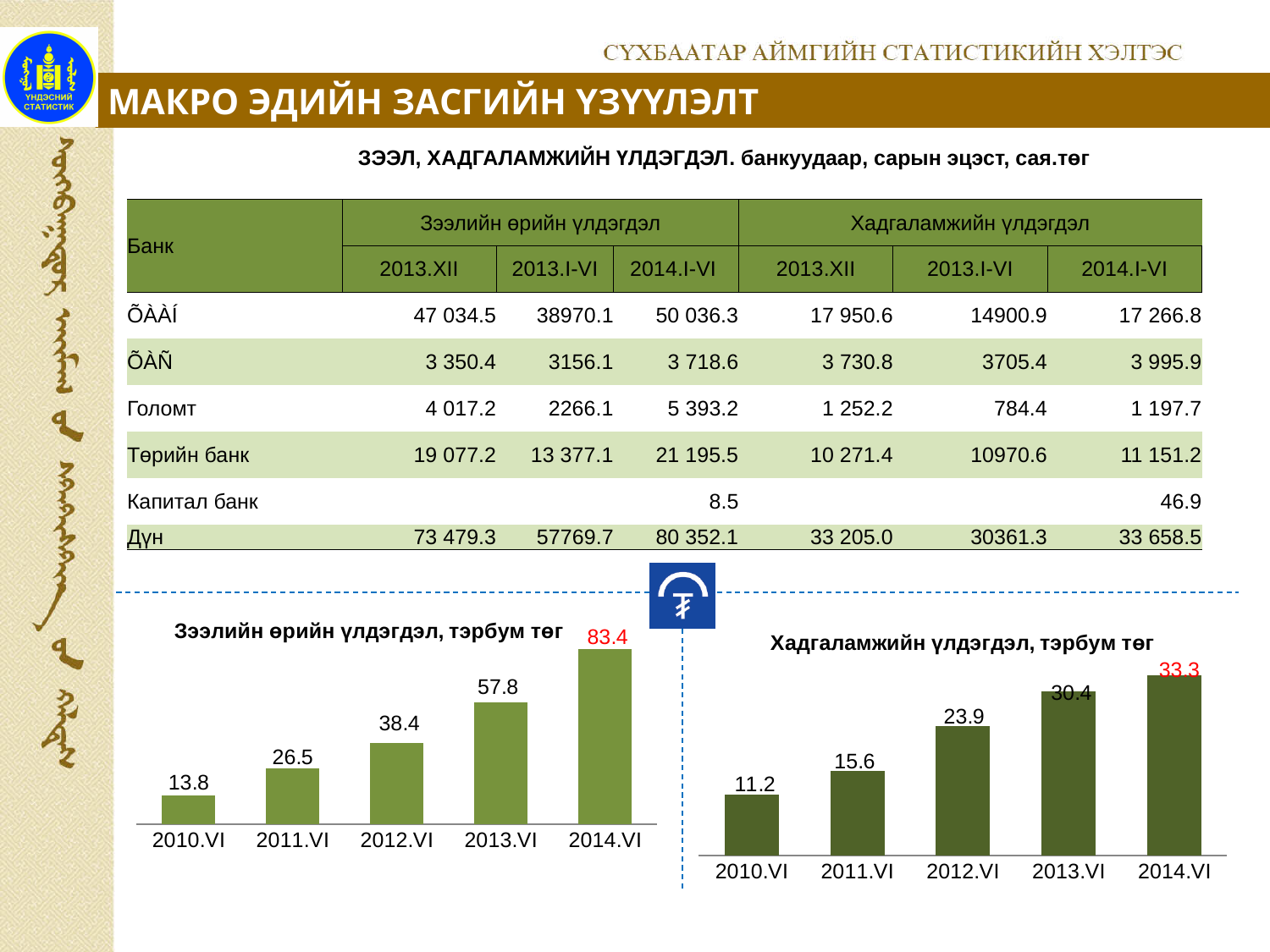
In the chart titled 'Зээлийн өрийн үлдэгдэл, тэрбум төг', which year has the lowest value? 2010.VI What type of chart is the chart titled 'Зээлийн өрийн үлдэгдэл, тэрбум төг'? Bar chart In the chart titled 'Хадгаламжийн үлдэгдэл, тэрбум төг', what is the difference between the 2013.VI and 2011.VI values? 14.8 In the chart titled 'Хадгаламжийн үлдэгдэл, тэрбум төг', which year has the highest value? 2014.VI How many bars are shown in the chart titled 'Хадгаламжийн үлдэгдэл, тэрбум төг'? 5 In the chart titled 'Хадгаламжийн үлдэгдэл, тэрбум төг', do the values rise or fall from 2010.VI to 2014.VI? Rise In the chart titled 'Зээлийн өрийн үлдэгдэл, тэрбум төг', which is larger, the value for 2012.VI or 2013.VI? 2013.VI In the chart titled 'Хадгаламжийн үлдэгдэл, тэрбум төг', what is the value for 2012.VI? 23.9 In the chart titled 'Зээлийн өрийн үлдэгдэл, тэрбум төг', what is the value for 2011.VI? 26.5 In the chart titled 'Хадгаламжийн үлдэгдэл, тэрбум төг', what is the value for 2010.VI? 11.2 In the chart titled 'Зээлийн өрийн үлдэгдэл, тэрбум төг', what is the difference between the 2014.VI and 2013.VI values? 25.6 In the chart titled 'Зээлийн өрийн үлдэгдэл, тэрбум төг', what is the value for 2014.VI? 83.4